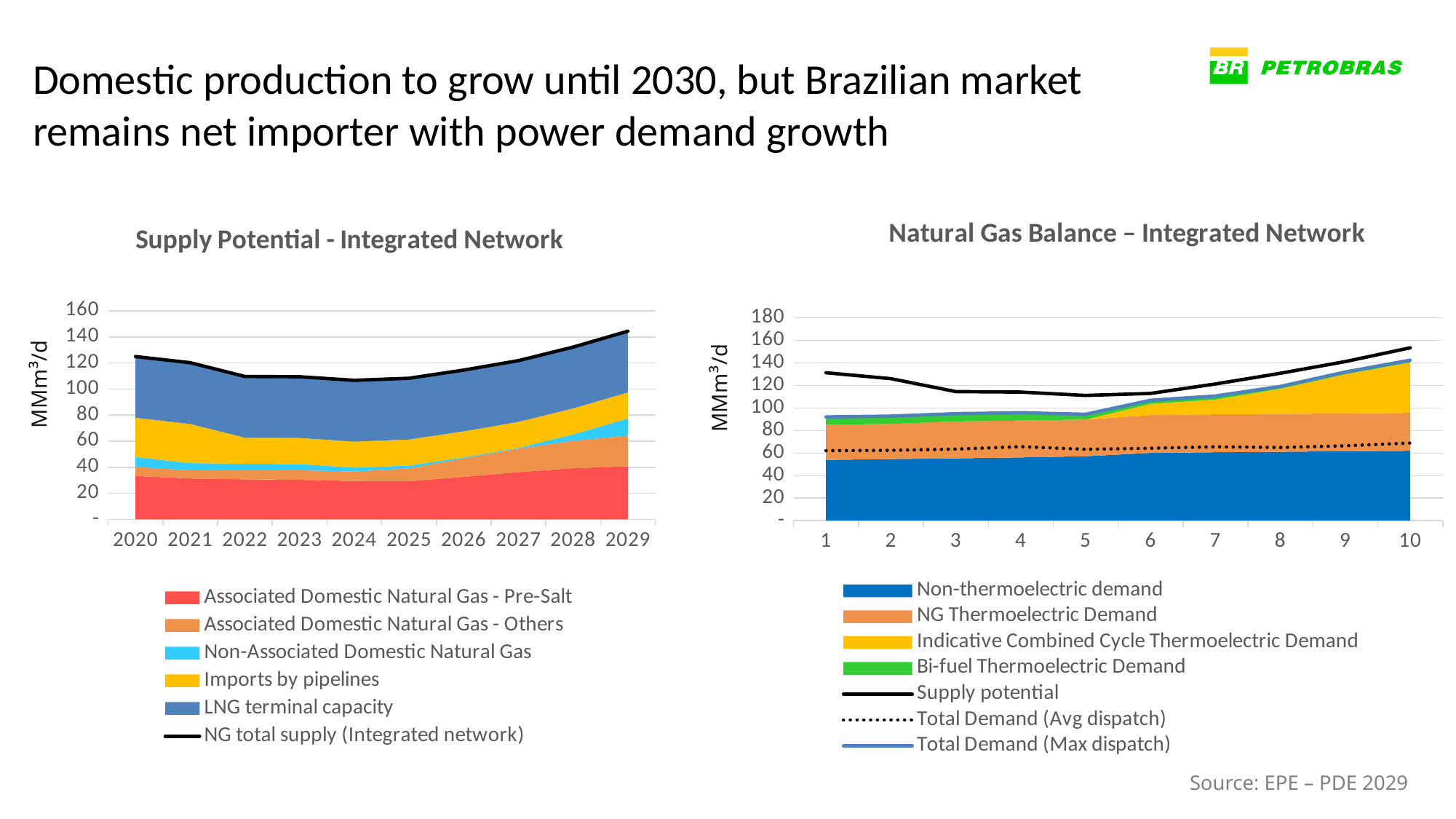
What kind of chart is the 'Supply Potential - Integrated Network' chart? Stacked area chart How many years are shown on the x axis of the 'Supply Potential - Integrated Network' chart? 10 What is the unit shown on the y axis of the 'Supply Potential - Integrated Network' chart? MMm³/d How many entries does the legend of the 'Supply Potential - Integrated Network' chart list? 6 In the 'Supply Potential - Integrated Network' chart, is the NG total supply (Integrated network) value for 2024 greater or less than 120? less In the 'Supply Potential - Integrated Network' chart, is the NG total supply (Integrated network) value for 2029 greater or less than 120? greater How many points are shown on the x axis of the 'Natural Gas Balance – Integrated Network' chart? 10 In the 'Natural Gas Balance – Integrated Network' chart, is the Total Demand (Avg dispatch) value at point 10 greater or less than 80? less In the 'Supply Potential - Integrated Network' chart, does the NG total supply (Integrated network) line rise or fall from 2025 to 2029? rise In the 'Natural Gas Balance – Integrated Network' chart, does the Supply potential line rise or fall from point 5 to point 10? rise How many entries does the legend of the 'Natural Gas Balance – Integrated Network' chart list? 7